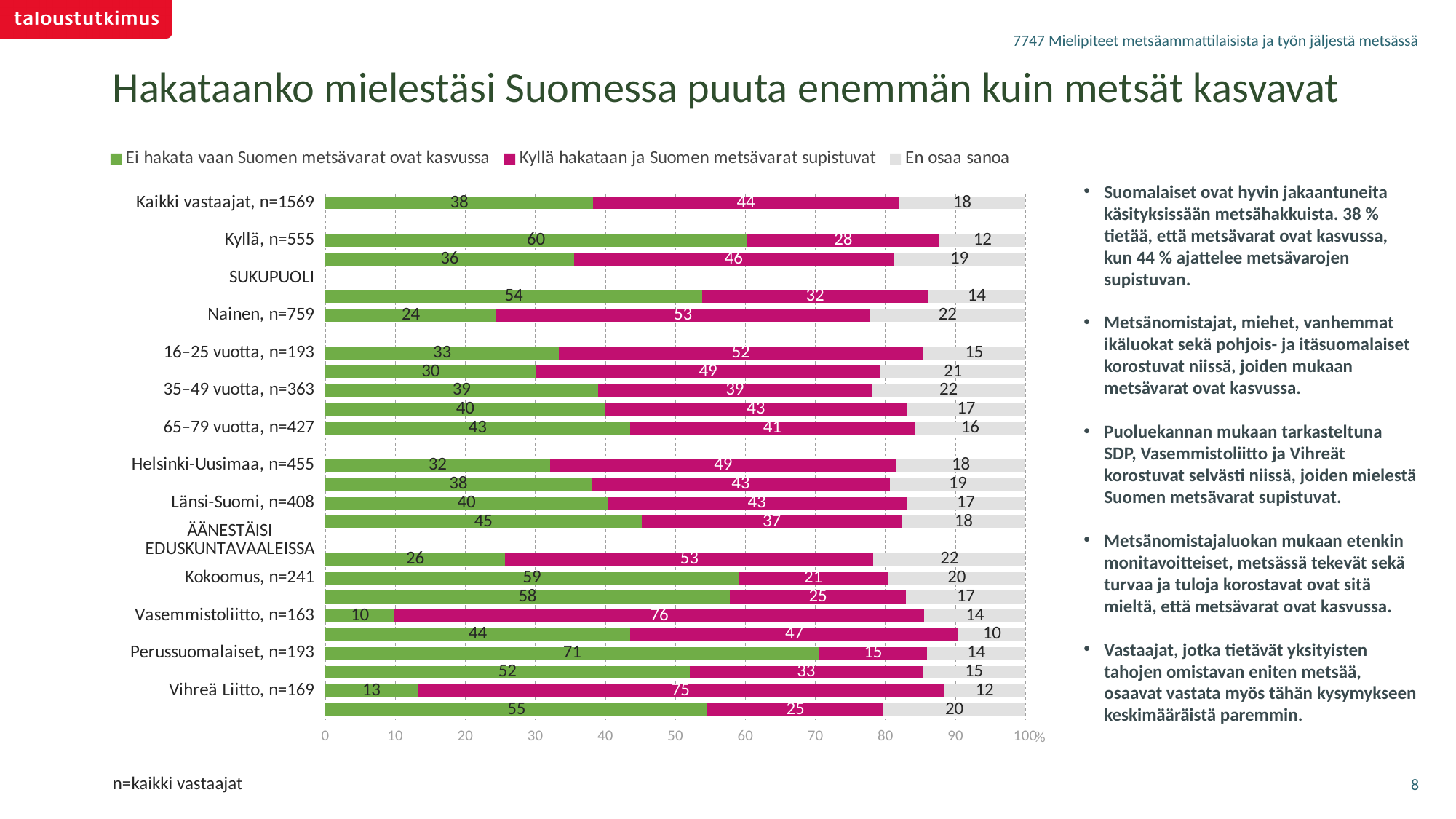
What is the value of 'Ei hakata vaan Suomen metsävarat ovat kasvussa' for Kaikki vastaajat, n=1569? 38 Among the labelled groups, which has the lowest 'Ei hakata vaan Suomen metsävarat ovat kasvussa' value? Vasemmistoliitto, n=163 What is the 'En osaa sanoa' value for Nainen, n=759? 22 What is the total of the stacked bar for Vihreä Liitto, n=169? 100 What is the value of 'Kyllä hakataan ja Suomen metsävarat supistuvat' for Kokoomus, n=241? 21 What kind of chart is shown on the slide? Stacked bar chart How many series does the legend list? 3 For Kaikki vastaajat, n=1569, what is the difference between the 'Kyllä hakataan ja Suomen metsävarat supistuvat' value and the 'Ei hakata vaan Suomen metsävarat ovat kasvussa' value? 6 Which is larger for Kyllä, n=555: the 'Ei hakata vaan Suomen metsävarat ovat kasvussa' value or the 'Kyllä hakataan ja Suomen metsävarat supistuvat' value? Ei hakata vaan Suomen metsävarat ovat kasvussa What is the value of 'Kyllä hakataan ja Suomen metsävarat supistuvat' for Vasemmistoliitto, n=163? 76 What is the value of 'Ei hakata vaan Suomen metsävarat ovat kasvussa' for Perussuomalaiset, n=193? 71 Among the labelled groups, which has the highest 'Ei hakata vaan Suomen metsävarat ovat kasvussa' value? Perussuomalaiset, n=193